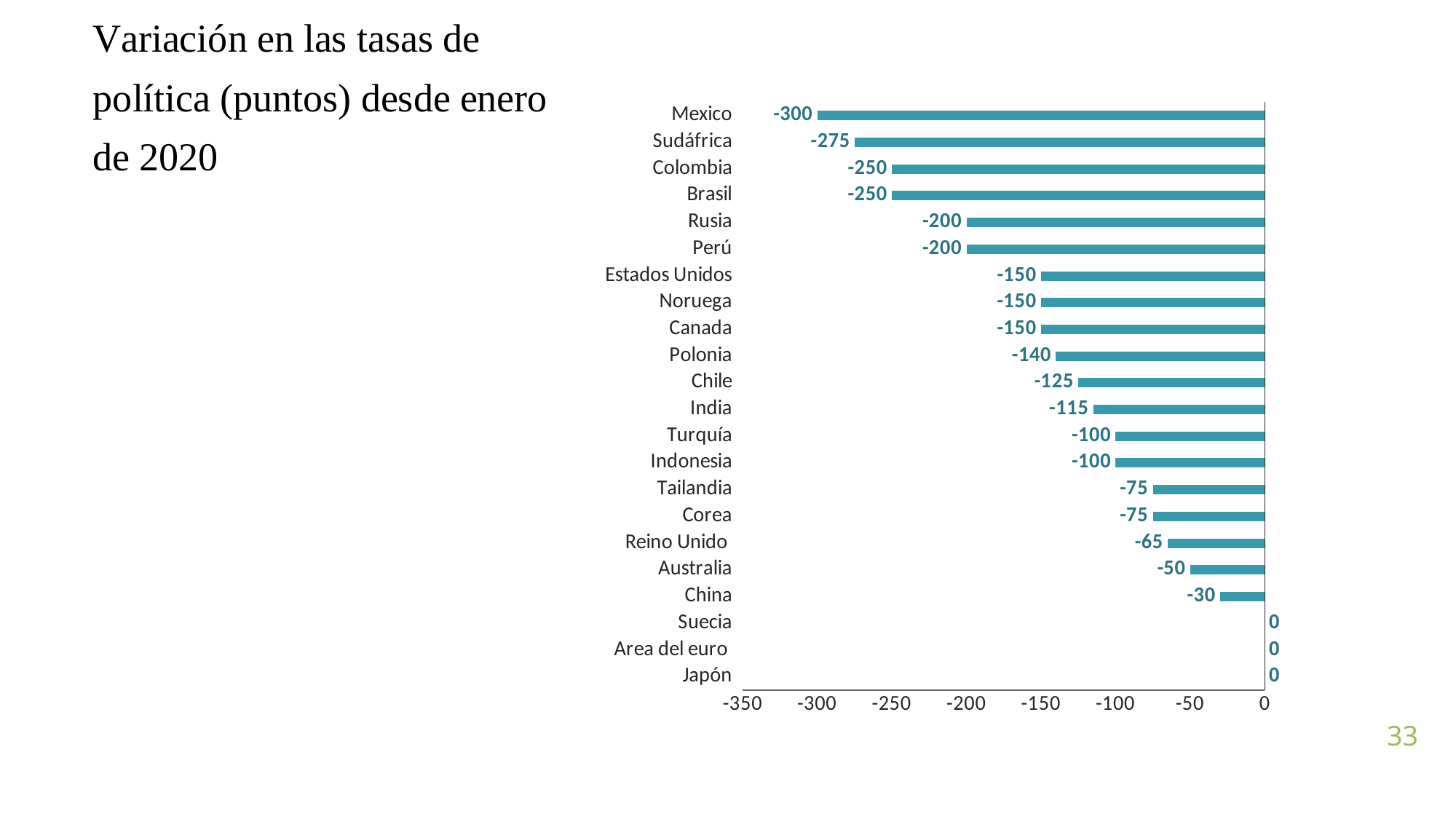
Which has a larger decrease, Colombia or Perú? Colombia What kind of chart is shown on the slide? Bar chart How many countries or regions are shown in the chart? 22 Which country has the largest decrease (the most negative value)? Mexico What is the value for Reino Unido? -65 Which has a larger decrease, China or Australia? Australia What is the value for Mexico? -300 What is the difference between the values for Sudáfrica and Rusia? 75 What is the value for Japón? 0 How many countries or regions have a value of 0? 3 What is the value for Polonia? -140 What is the difference between the values for Chile and India? 10